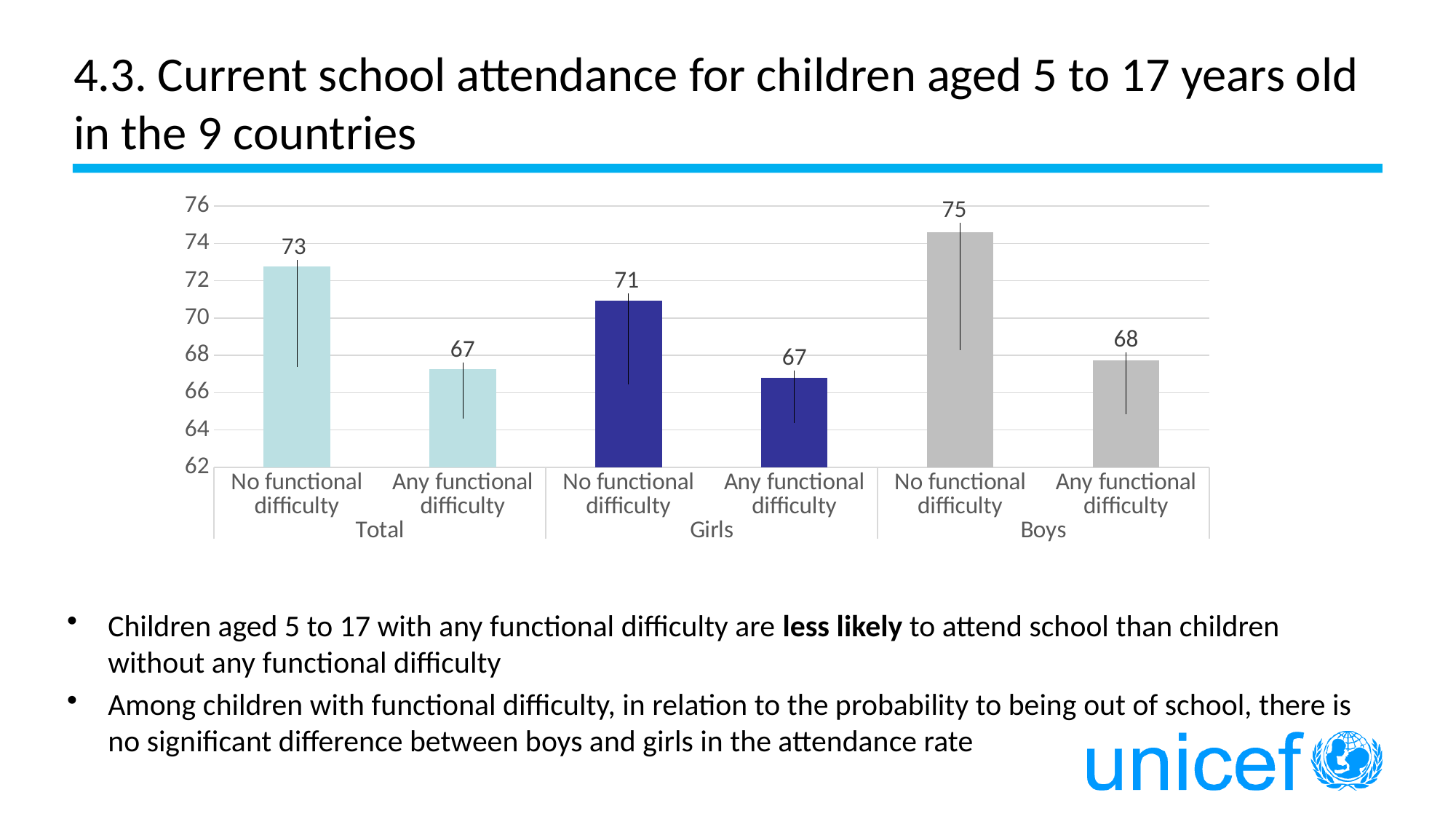
Which is larger: 'No functional difficulty' for Girls or 'No functional difficulty' for Boys? No functional difficulty for Boys What kind of chart is shown on the slide? Bar chart Is the value for 'Any functional difficulty' in the Total group greater or less than 70? less What is the value for 'No functional difficulty' in the Total group? 73 Which bar has the highest value? No functional difficulty (Boys) What is the value for 'Any functional difficulty' among Boys? 68 What is the value for 'No functional difficulty' among Boys? 75 What is the difference between 'No functional difficulty' and 'Any functional difficulty' in the Total group? 6 How many bars are plotted in the chart? 6 What are the three group labels shown along the x axis? Total, Girls, Boys What is the value for 'Any functional difficulty' among Girls? 67 What is the difference between 'No functional difficulty' for Boys and 'No functional difficulty' for Girls? 4